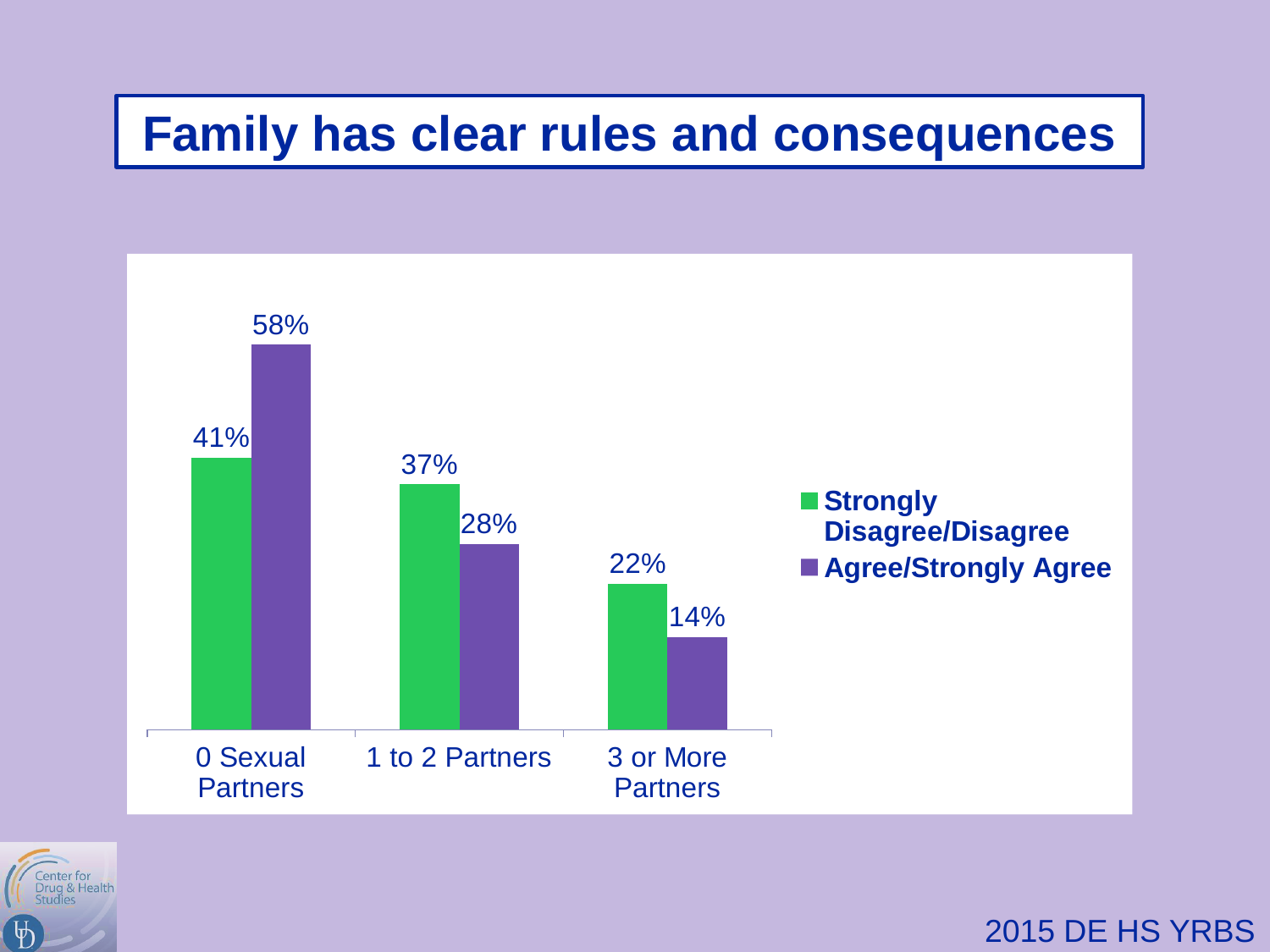
Which category has the highest Agree/Strongly Agree value? 0 Sexual Partners What is the value for Strongly Disagree/Disagree for 1 to 2 Partners? 37% What is the value for Agree/Strongly Agree for 0 Sexual Partners? 58% What is the difference between the Agree/Strongly Agree and Strongly Disagree/Disagree values for 0 Sexual Partners? 17% Which category has the lowest Strongly Disagree/Disagree value? 3 or More Partners How many series does the legend list? 2 What kind of chart is shown on the slide? Bar chart What is the value for Agree/Strongly Agree for 3 or More Partners? 14% What is the difference between the Strongly Disagree/Disagree values for 1 to 2 Partners and 3 or More Partners? 15% Do the Agree/Strongly Agree values rise or fall from 0 Sexual Partners to 3 or More Partners? Fall For 1 to 2 Partners, which is larger: Strongly Disagree/Disagree or Agree/Strongly Agree? Strongly Disagree/Disagree How many categories are shown on the x axis? 3